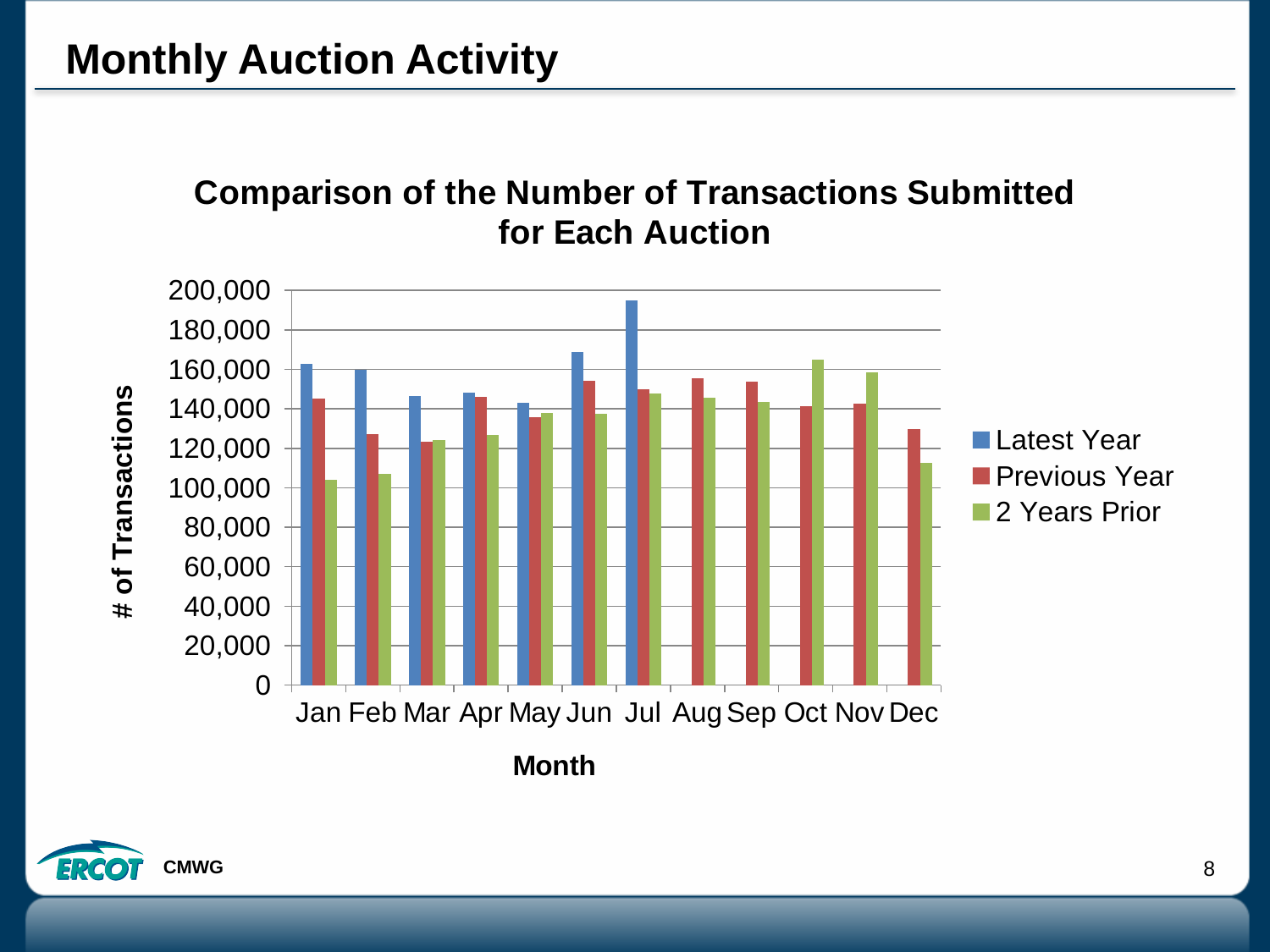
What is the title of the vertical axis? # of Transactions Is the Latest Year value for Jul greater or less than 180,000? greater In Jan, which is larger: the Latest Year value or the Previous Year value? Latest Year Is the 2 Years Prior value for Jan greater or less than 120,000? less Is the Previous Year value for Mar greater or less than 140,000? less How many months are shown on the x axis? 12 In which month is the 2 Years Prior value highest? Oct For how many months is a Latest Year bar plotted? 7 How many series does the legend list? 3 What kind of chart is shown on the slide? bar chart In which month is the 2 Years Prior value lowest? Jan In which month is the Latest Year value highest? Jul